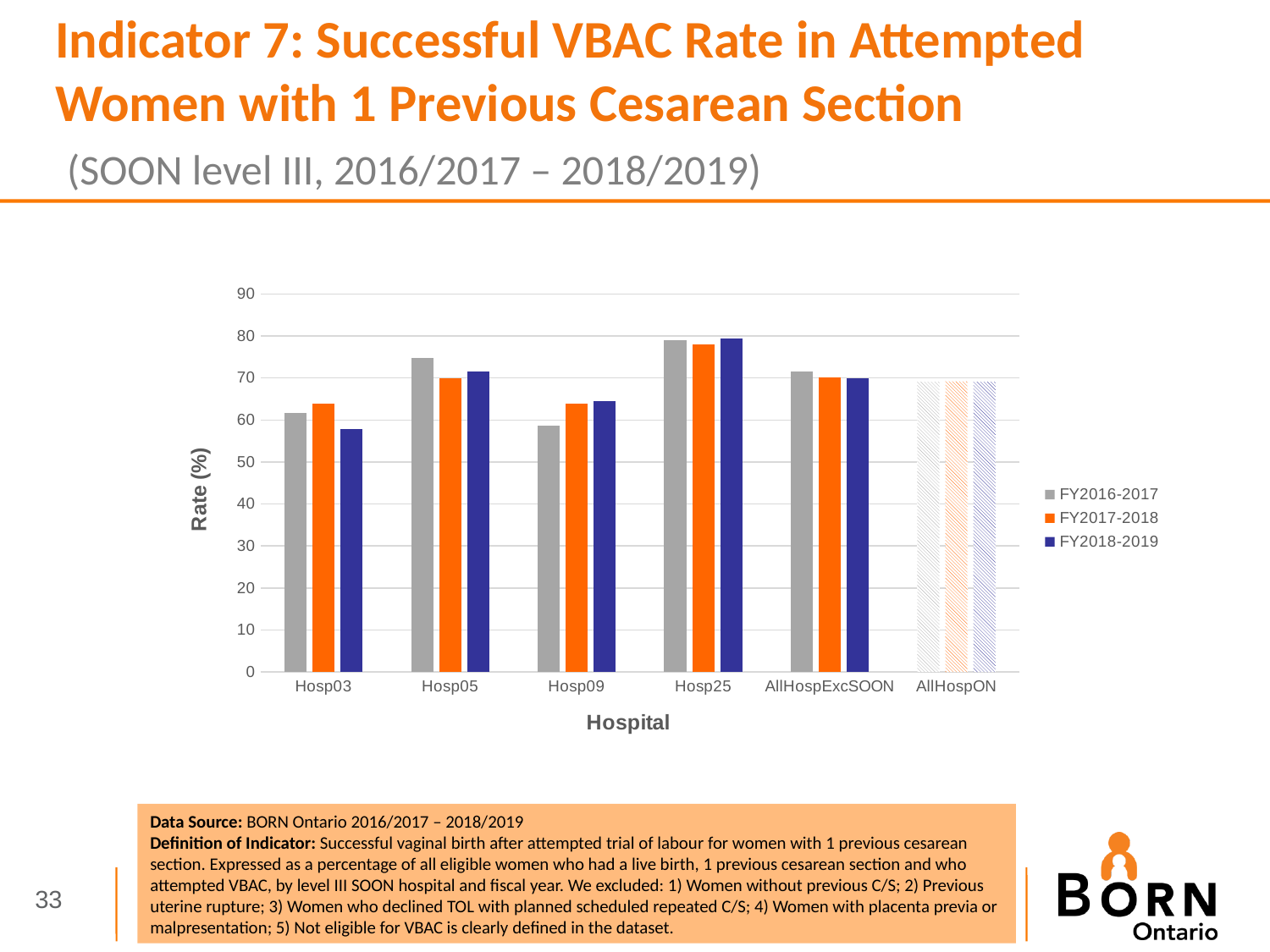
Which hospital has the lowest FY2018-2019 value? Hosp03 Is the FY2016-2017 value for Hosp05 greater or less than 70? greater Is the FY2018-2019 value for Hosp03 greater or less than 60? less How many hospital categories are shown on the x axis? 6 For Hosp09, do the values rise or fall from FY2016-2017 to FY2018-2019? rise Is the FY2016-2017 value for Hosp25 greater or less than 70? greater Which is larger for FY2016-2017: Hosp05 or Hosp09? Hosp05 What is the title of the y axis? Rate (%) Which hospital has the highest FY2016-2017 value? Hosp25 For Hosp03, which is larger: the FY2017-2018 value or the FY2018-2019 value? FY2017-2018 What kind of chart is shown on the slide? Bar chart How many series does the legend list? 3